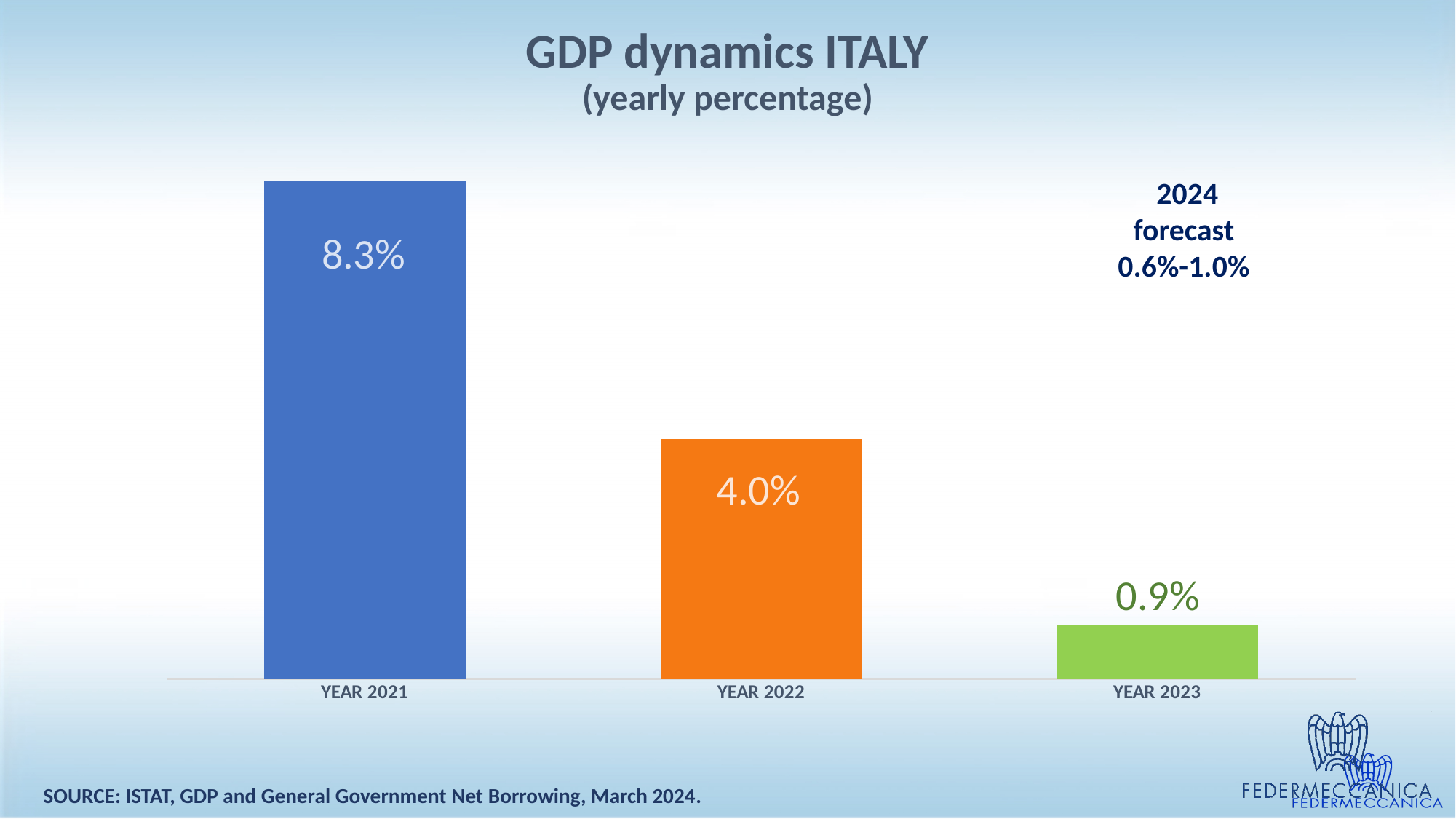
What is the difference between the values for YEAR 2022 and YEAR 2023? 3.1% What is the difference between the values for YEAR 2021 and YEAR 2022? 4.3% What is the 2024 forecast range shown on the slide? 0.6%-1.0% How many years are plotted as bars in the chart? 3 Which year has the lowest GDP growth value? YEAR 2023 Which is larger, the value for YEAR 2022 or the value for YEAR 2023? YEAR 2022 Which year has the highest GDP growth value? YEAR 2021 What is the GDP growth value shown for YEAR 2023? 0.9% What is the GDP growth value shown for YEAR 2022? 4.0% What kind of chart is shown on the slide? Bar chart What is the GDP growth value shown for YEAR 2021? 8.3% Do the GDP values rise or fall from YEAR 2021 to YEAR 2023? Fall